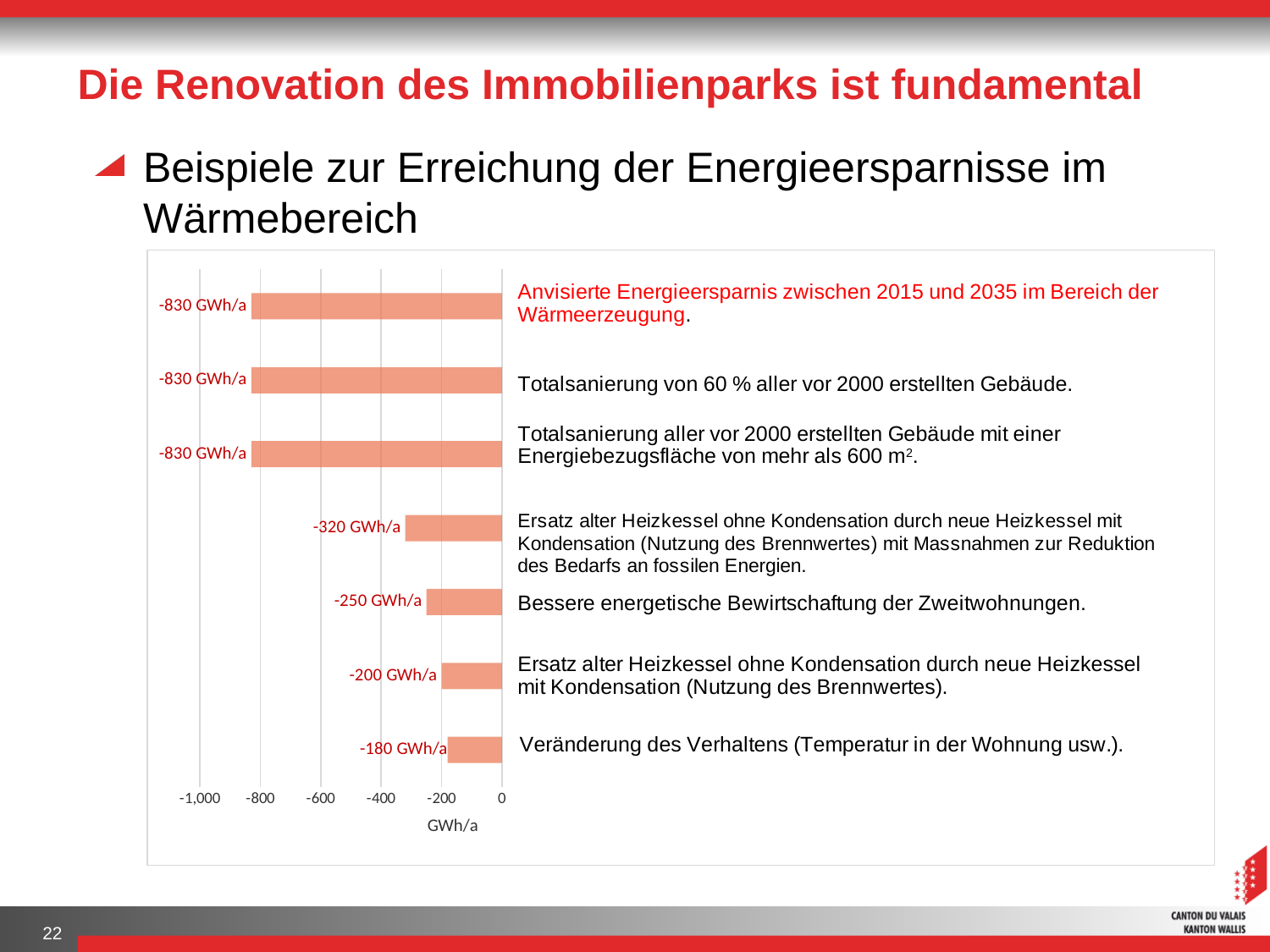
What unit is shown on the horizontal axis of the chart? GWh/a What is the value shown for "Totalsanierung von 60 % aller vor 2000 erstellten Gebäude"? -830 GWh/a How many bars are plotted in the chart? 7 What is the value shown for "Bessere energetische Bewirtschaftung der Zweitwohnungen"? -250 GWh/a Which represents a larger energy saving: "Bessere energetische Bewirtschaftung der Zweitwohnungen" or "Ersatz alter Heizkessel ohne Kondensation durch neue Heizkessel mit Kondensation (Nutzung des Brennwertes)"? Bessere energetische Bewirtschaftung der Zweitwohnungen What is the difference between the value for "Bessere energetische Bewirtschaftung der Zweitwohnungen" and the value for "Veränderung des Verhaltens"? 70 GWh/a Which measure has the smallest energy saving (the bar closest to zero)? Veränderung des Verhaltens (Temperatur in der Wohnung usw.) How many bars show a value of -830 GWh/a? 3 What is the value shown for "Ersatz alter Heizkessel ohne Kondensation durch neue Heizkessel mit Kondensation (Nutzung des Brennwertes)" without additional measures? -200 GWh/a What kind of chart is shown on the slide? bar chart What is the value shown for the replacement of old boilers with condensing boilers combined with measures to reduce fossil energy demand? -320 GWh/a What is the value shown for "Veränderung des Verhaltens (Temperatur in der Wohnung usw.)"? -180 GWh/a